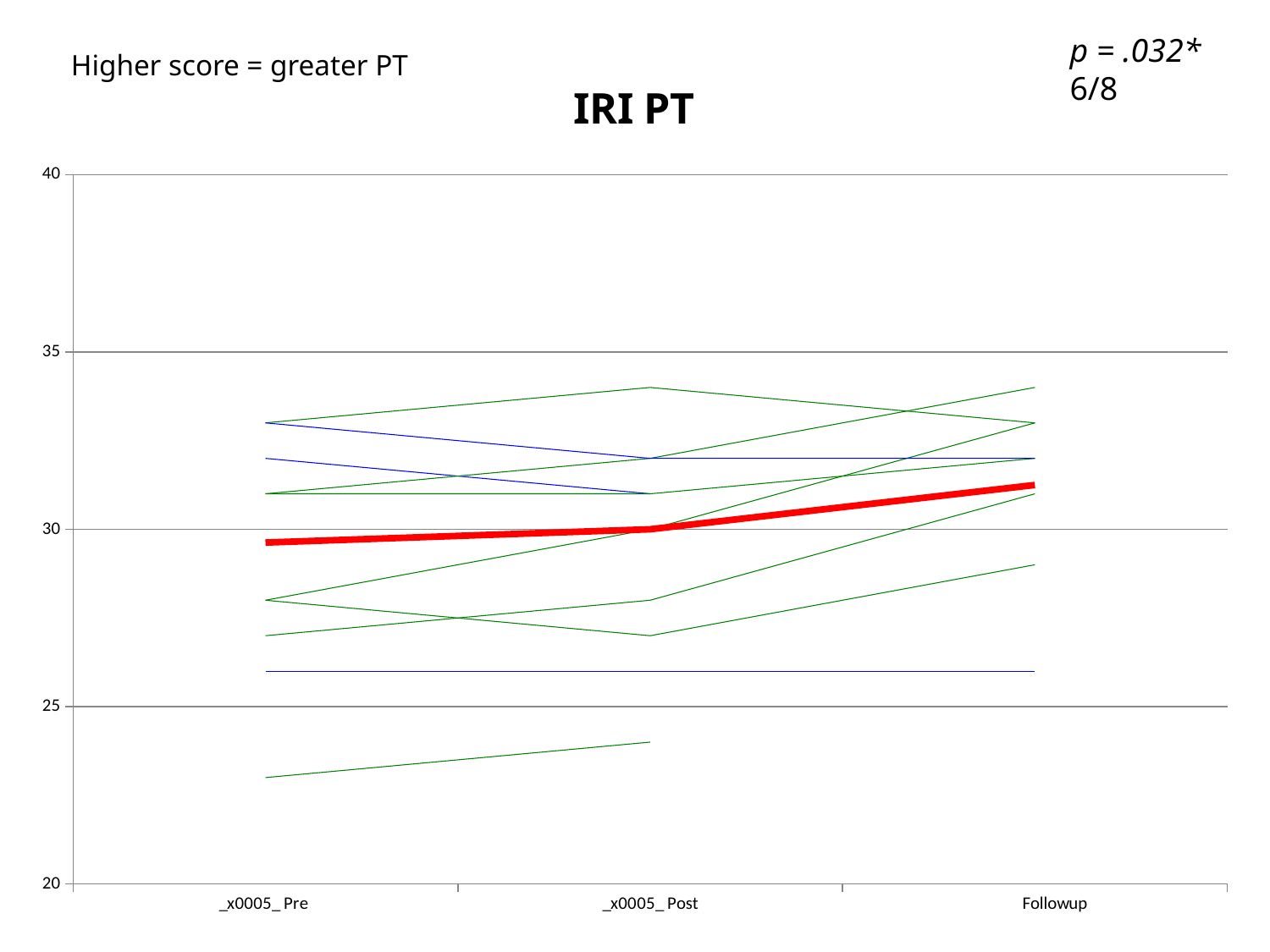
What is the maximum value shown on the y axis? 40 Is the highest line at Followup greater or less than 35? less Does the thick red line rise or fall from Pre to Followup? rises Is the highest line at Post greater or less than 35? less Is the lowest line at Pre greater or less than 25? less How many time points are shown along the x axis? 3 What is the title of the chart? IRI PT What is the label of the last category on the x axis? Followup What kind of chart is shown on the slide? line chart